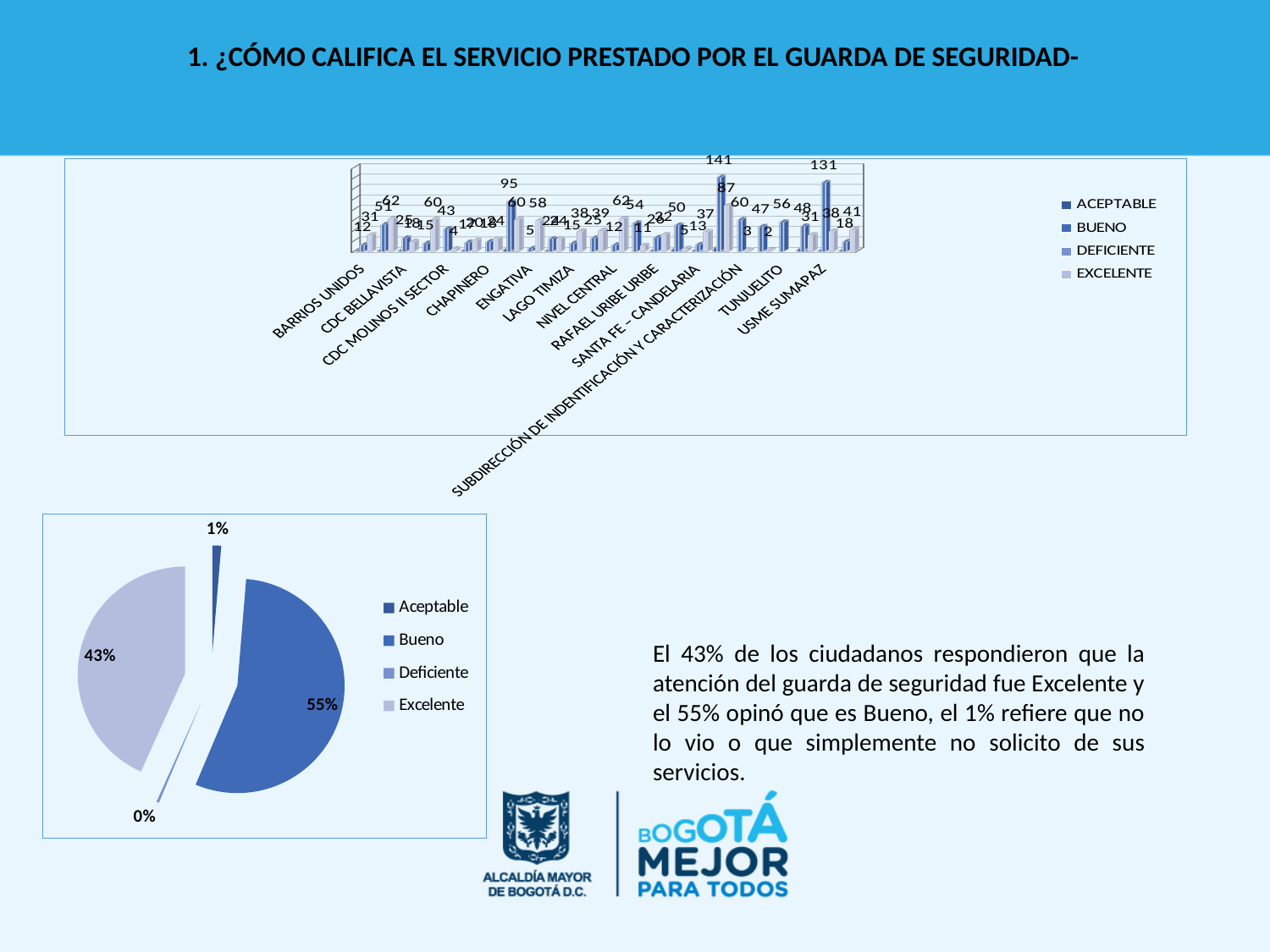
In the pie chart at the bottom left, what share is labelled for Deficiente? 0% In the pie chart at the bottom left, what share is labelled for Bueno? 55% In the pie chart at the bottom left, which category has the smallest slice? Deficiente In the pie chart at the bottom left, what share is labelled for Aceptable? 1% What kind of chart is the chart at the top of the slide? Bar chart In the pie chart at the bottom left, which is larger, Excelente or Aceptable? Excelente In the pie chart at the bottom left, what share is labelled for Excelente? 43% In the bar chart at the top of the slide, what is the highest data label shown? 141 In the pie chart at the bottom left, how many percentage points larger is Bueno than Excelente? 12 How many series does the legend of the bar chart at the top of the slide list? 4 In the pie chart at the bottom left, which category has the largest slice? Bueno How many categories does the legend of the pie chart at the bottom left list? 4